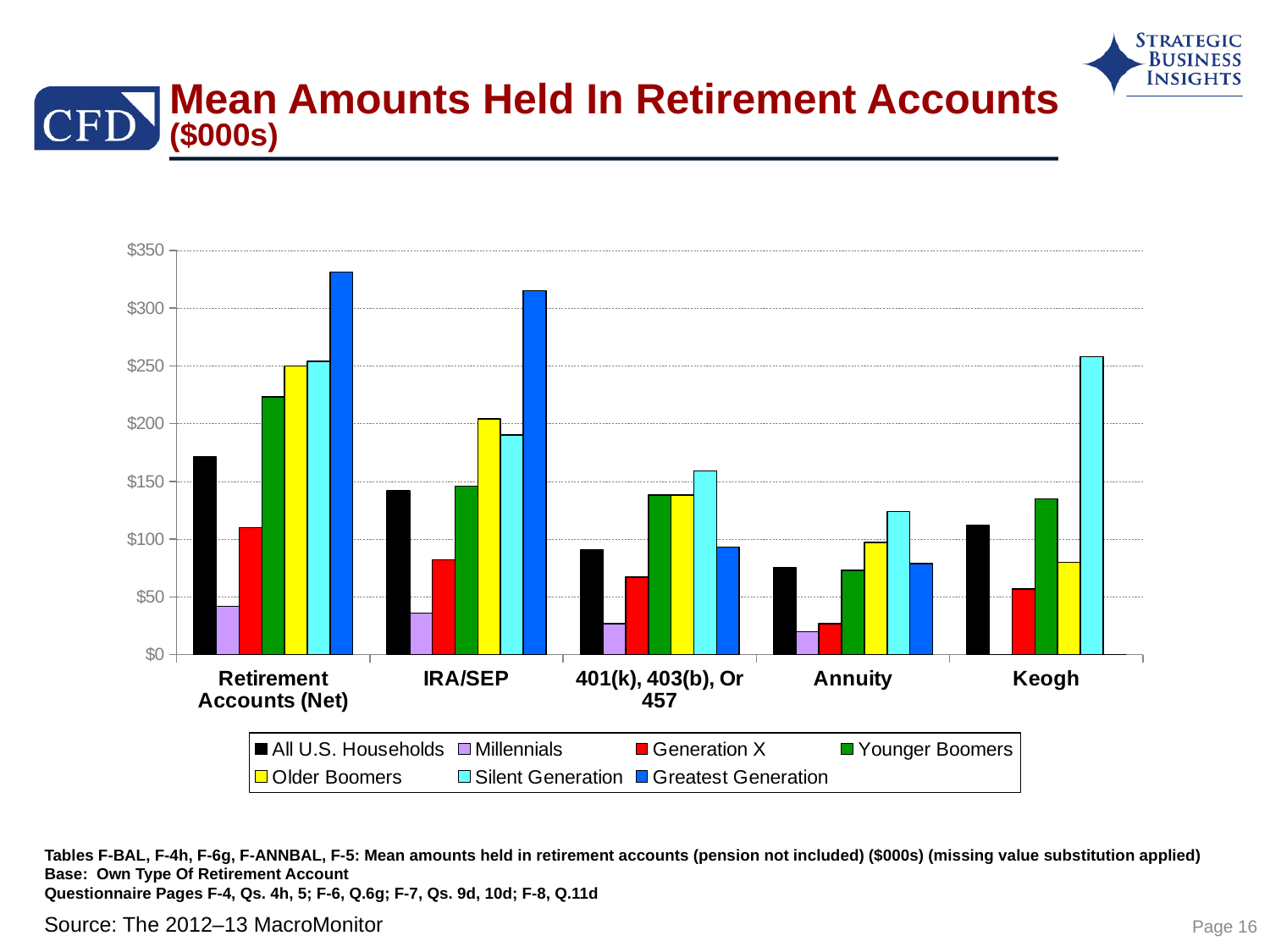
Is the value for All U.S. Households in Retirement Accounts (Net) greater or less than $150? greater Which series has the highest value in the Annuity category? Silent Generation How many account categories are shown along the x axis? 5 How many series does the legend list? 7 What kind of chart is shown on the slide? bar chart Is the value for Greatest Generation in IRA/SEP greater or less than $300? greater Which generation has the lowest mean amount for Retirement Accounts (Net)? Millennials In the Annuity category, which is larger: Silent Generation or Older Boomers? Silent Generation Which generation has the highest mean amount for Retirement Accounts (Net)? Greatest Generation What is the title of the chart? Mean Amounts Held In Retirement Accounts ($000s) Which series has the highest value in the Keogh category? Silent Generation Is the value for Millennials in Retirement Accounts (Net) greater or less than $50? less